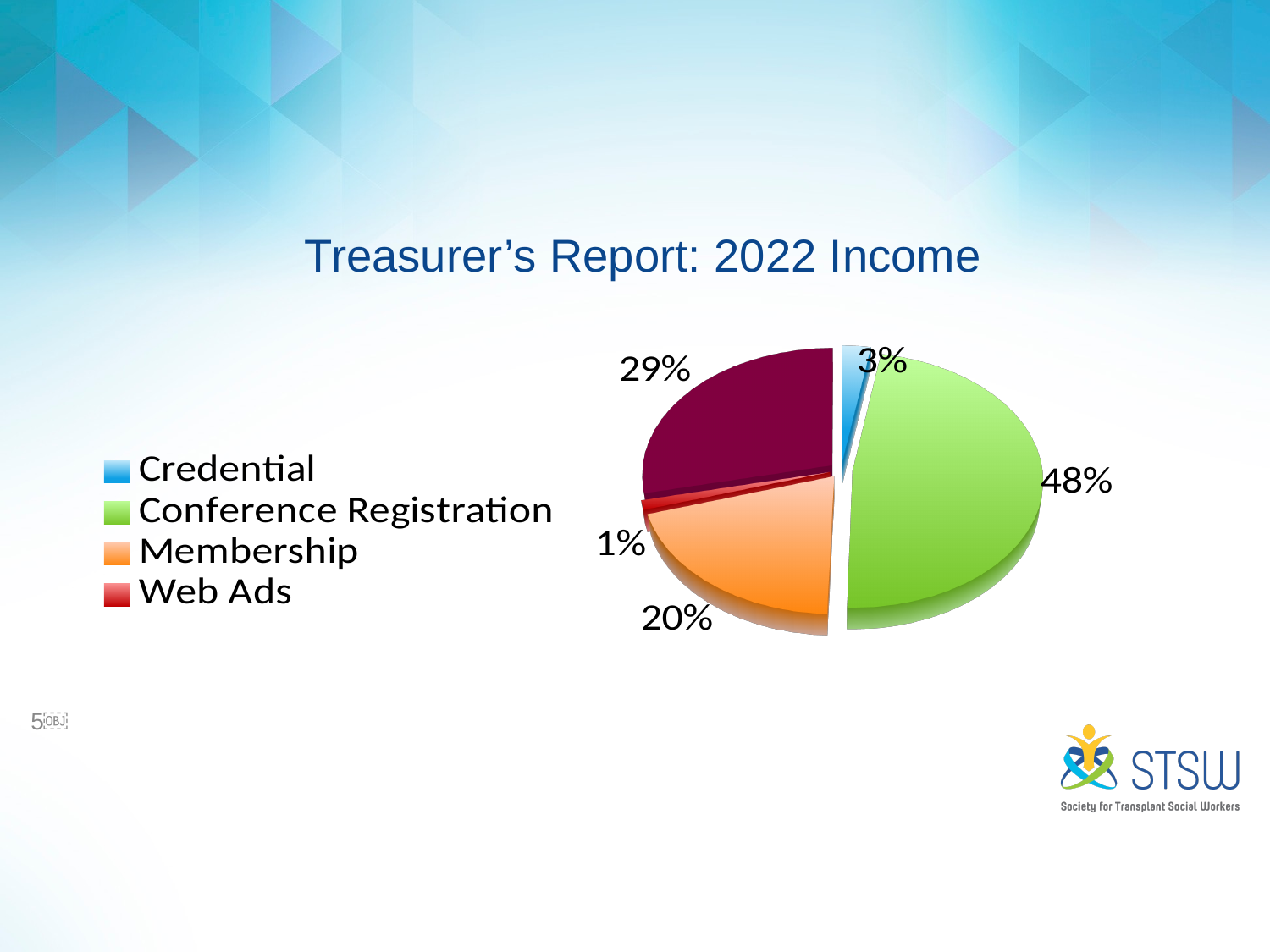
Which income source has the smallest share of the pie? Web Ads How many entries does the legend list? 4 What is the difference in percentage points between the Conference Registration share and the Membership share? 28 What share of 2022 income does Credential represent? 3% What share of 2022 income does Web Ads represent? 1% Which is larger, the share for Membership or the share for Credential? Membership What share of 2022 income does Conference Registration represent? 48% Which income source has the largest share of the pie? Conference Registration What type of chart is shown on the slide? pie chart What is the difference in percentage points between the Credential share and the Web Ads share? 2 What is the title of the slide containing the pie chart? Treasurer's Report: 2022 Income